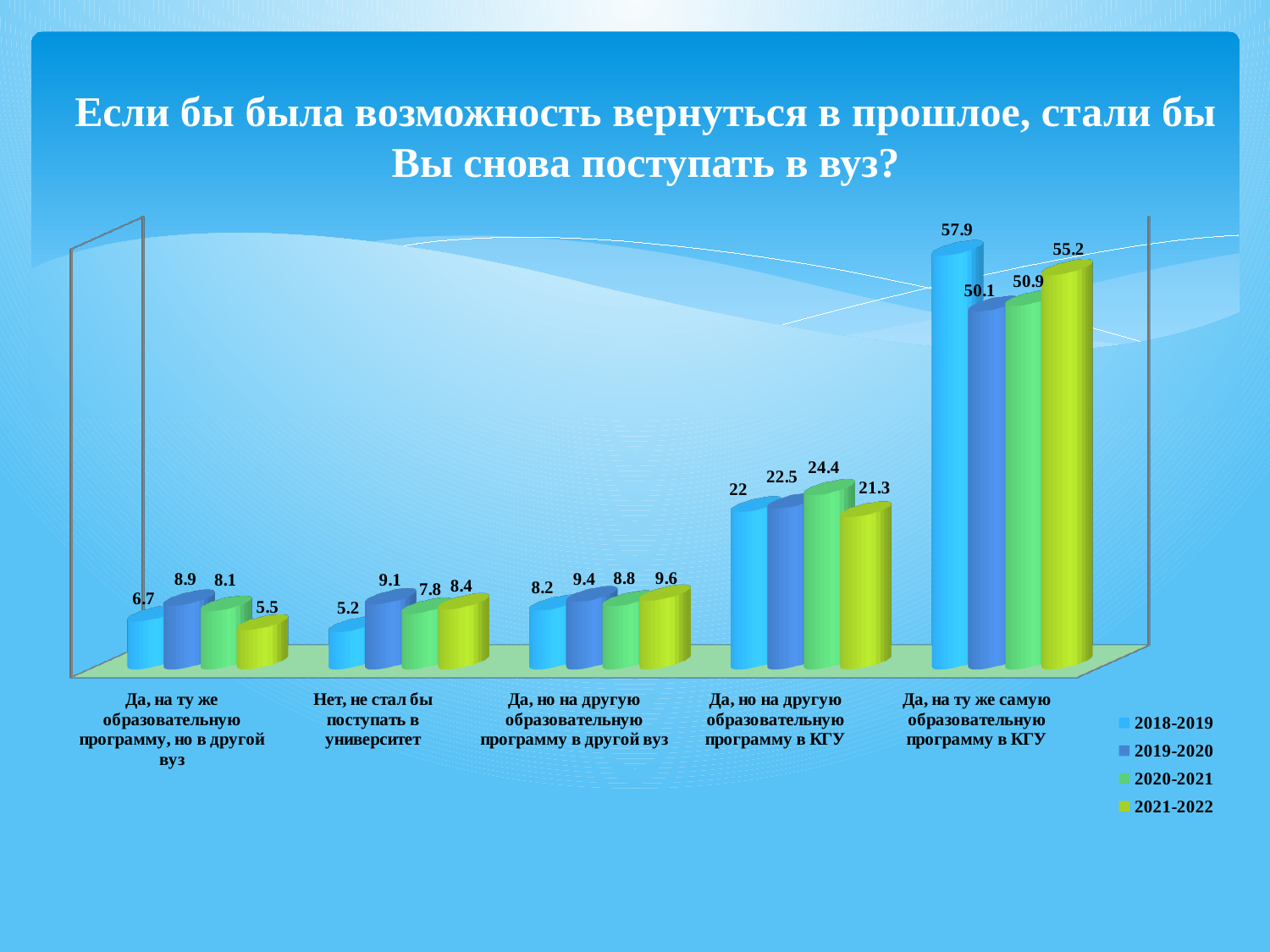
What is the value for 2021-2022 in the category "Да, на ту же образовательную программу, но в другой вуз"? 5.5 What is the value for 2018-2019 in the category "Да, на ту же самую образовательную программу в КГУ"? 57.9 Which category has the highest value for the 2021-2022 series? Да, на ту же самую образовательную программу в КГУ What is the value for 2020-2021 in the category "Да, но на другую образовательную программу в КГУ"? 24.4 What is the value for 2019-2020 in the category "Нет, не стал бы поступать в университет"? 9.1 In the category "Да, но на другую образовательную программу в КГУ", which is larger: the 2019-2020 value or the 2021-2022 value? 2019-2020 What is the difference between the 2018-2019 and 2019-2020 values in the category "Да, на ту же самую образовательную программу в КГУ"? 7.8 How many response categories are shown on the x axis? 5 Which category has the lowest value for the 2018-2019 series? Нет, не стал бы поступать в университет Which series is shown in yellow-green in the legend? 2021-2022 What kind of chart is shown on the slide? Bar chart How many series does the legend list? 4